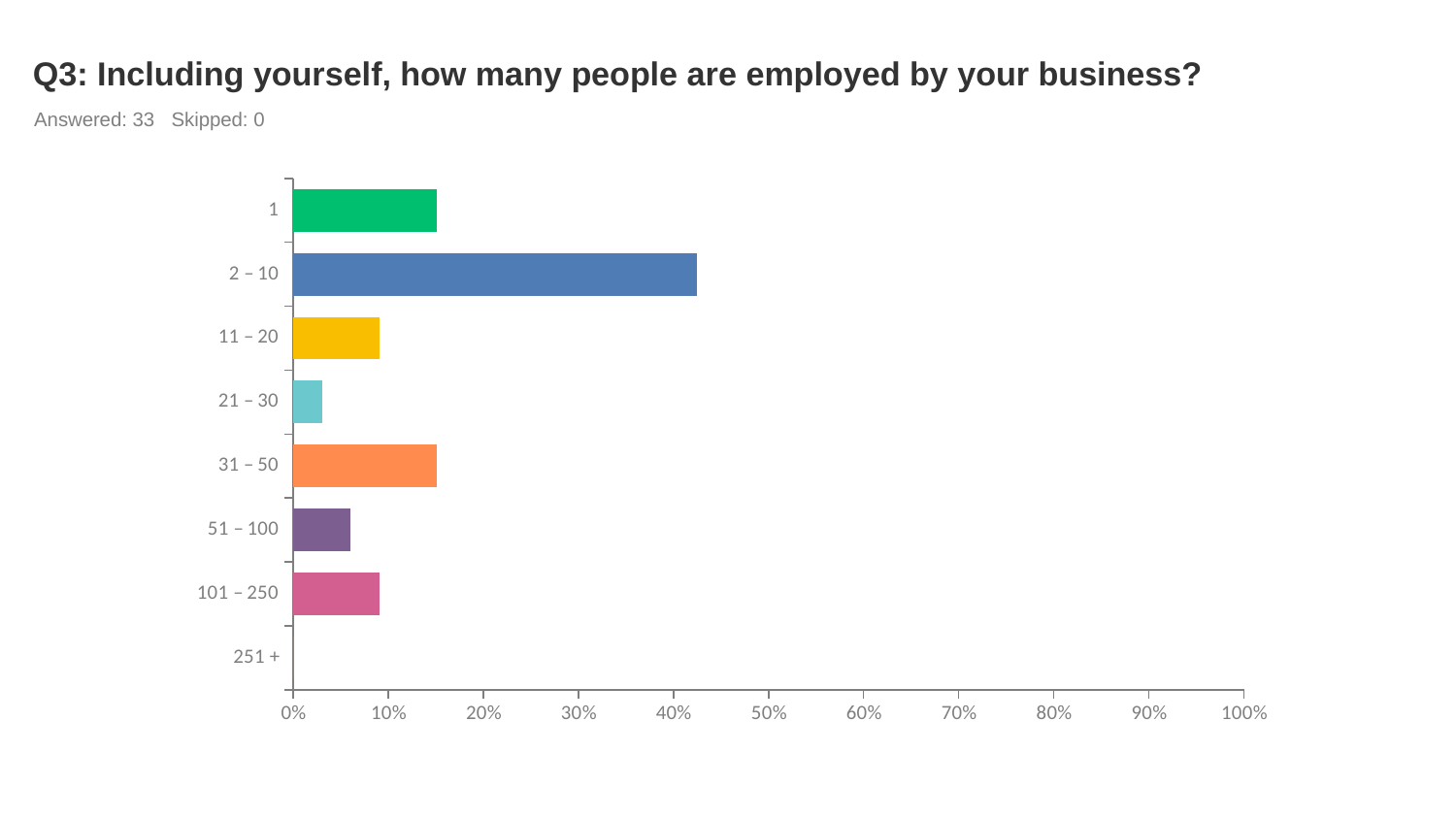
Is the value for 21 – 30 greater or less than 10%? less Which is larger, the value for 11 – 20 or the value for 21 – 30? 11 – 20 How many respondents answered this question according to the slide? 33 Which category has the highest percentage? 2 – 10 Is the value for 51 – 100 greater or less than 10%? less Which category has the lowest percentage? 251 + Which is larger, the value for 2 – 10 or the value for 1? 2 – 10 What is the value for the 251 + category? 0% Is the value for 1 greater or less than 10%? greater What kind of chart is shown on the slide? bar chart How many employee-count categories are shown on the chart? 8